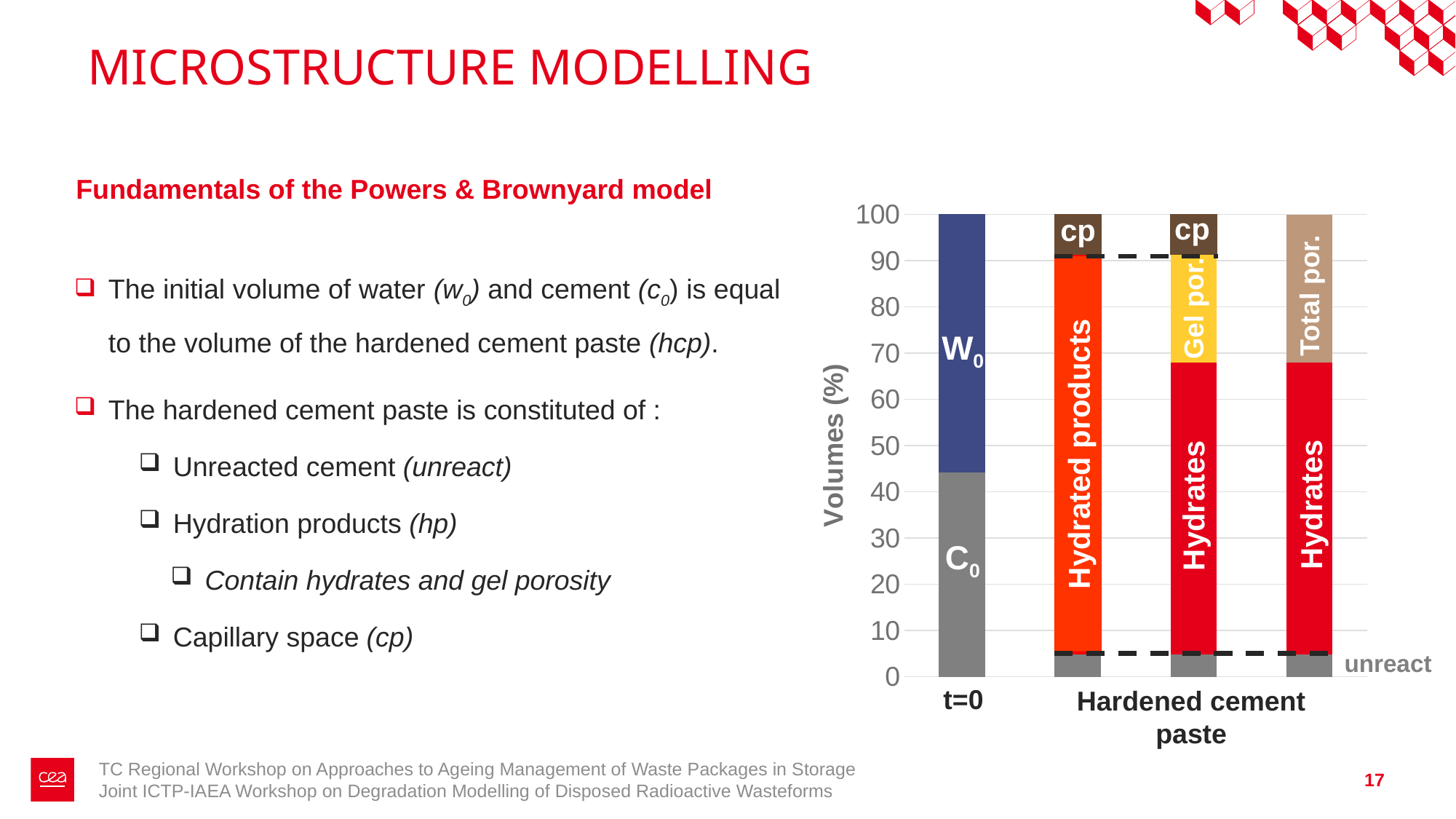
Is the top of the unreact segment in the Hardened cement paste bars greater or less than 10? less In the t=0 bar, is the top of the C0 segment greater or less than 40? greater In the t=0 bar, which segment is larger, W0 or C0? W0 In the bar with the Gel por. segment, which segment is larger, Hydrates or Gel por.? Hydrates What is the highest value shown on the vertical axis of the chart? 100 In the bar with the Gel por. segment, is the top of the Gel por. segment greater or less than 80? greater How many bars are plotted in the chart? 4 What is the title of the vertical axis of the chart? Volumes (%) What kind of chart is shown on the slide? stacked bar chart What are the two category labels shown on the horizontal axis of the chart? t=0 and Hardened cement paste